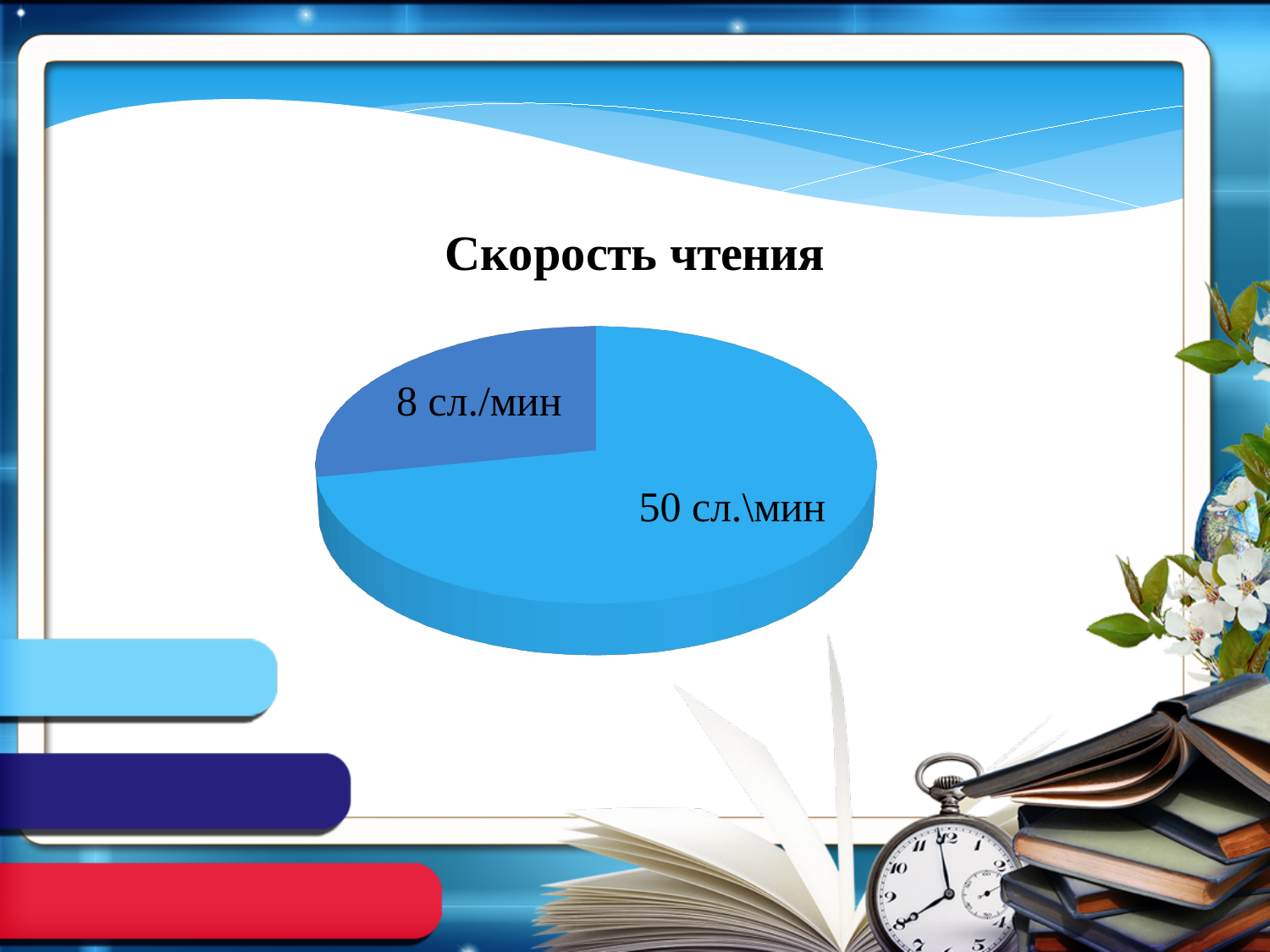
What value is printed on the light blue slice of the pie chart? 50 сл.\мин How many slices does the pie chart have? 2 What colour is the slice labelled 8 сл./мин? dark blue What is the label on the largest slice of the pie chart? 50 сл.\мин Does the pie chart show a legend? no Which slice is larger, the one labelled 8 сл./мин or the one labelled 50 сл.\мин? 50 сл.\мин What is the title of the chart? Скорость чтения What is the label on the smallest slice of the pie chart? 8 сл./мин What is the difference between the two values shown on the pie chart, 50 and 8? 42 What kind of chart is shown on the slide? pie chart